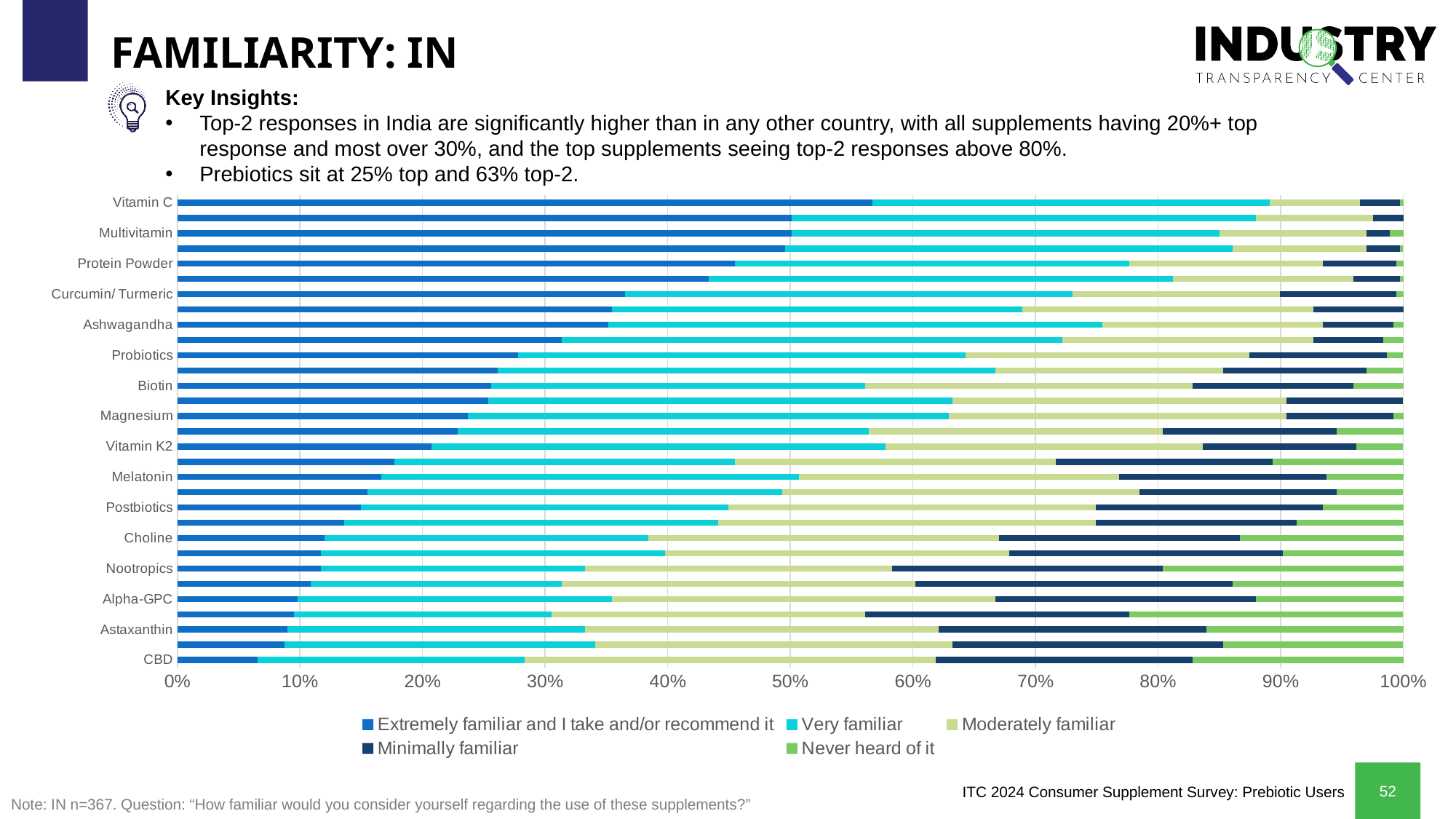
Is the 'Never heard of it' share for CBD greater or less than 10%? greater How many series does the legend list? 5 Is the 'Extremely familiar and I take and/or recommend it' value for Vitamin C greater or less than 50%? greater Which has a larger 'Extremely familiar and I take and/or recommend it' segment, Vitamin C or CBD? Vitamin C Is the 'Extremely familiar and I take and/or recommend it' value for CBD greater or less than 10%? less Which labeled supplement has the smallest 'Extremely familiar and I take and/or recommend it' segment? CBD What kind of chart is shown on the slide? Stacked bar chart Which labeled supplement has the largest 'Extremely familiar and I take and/or recommend it' segment? Vitamin C Moving from the top of the chart (Vitamin C) to the bottom (CBD), does the 'Extremely familiar and I take and/or recommend it' segment generally increase or decrease? Decrease